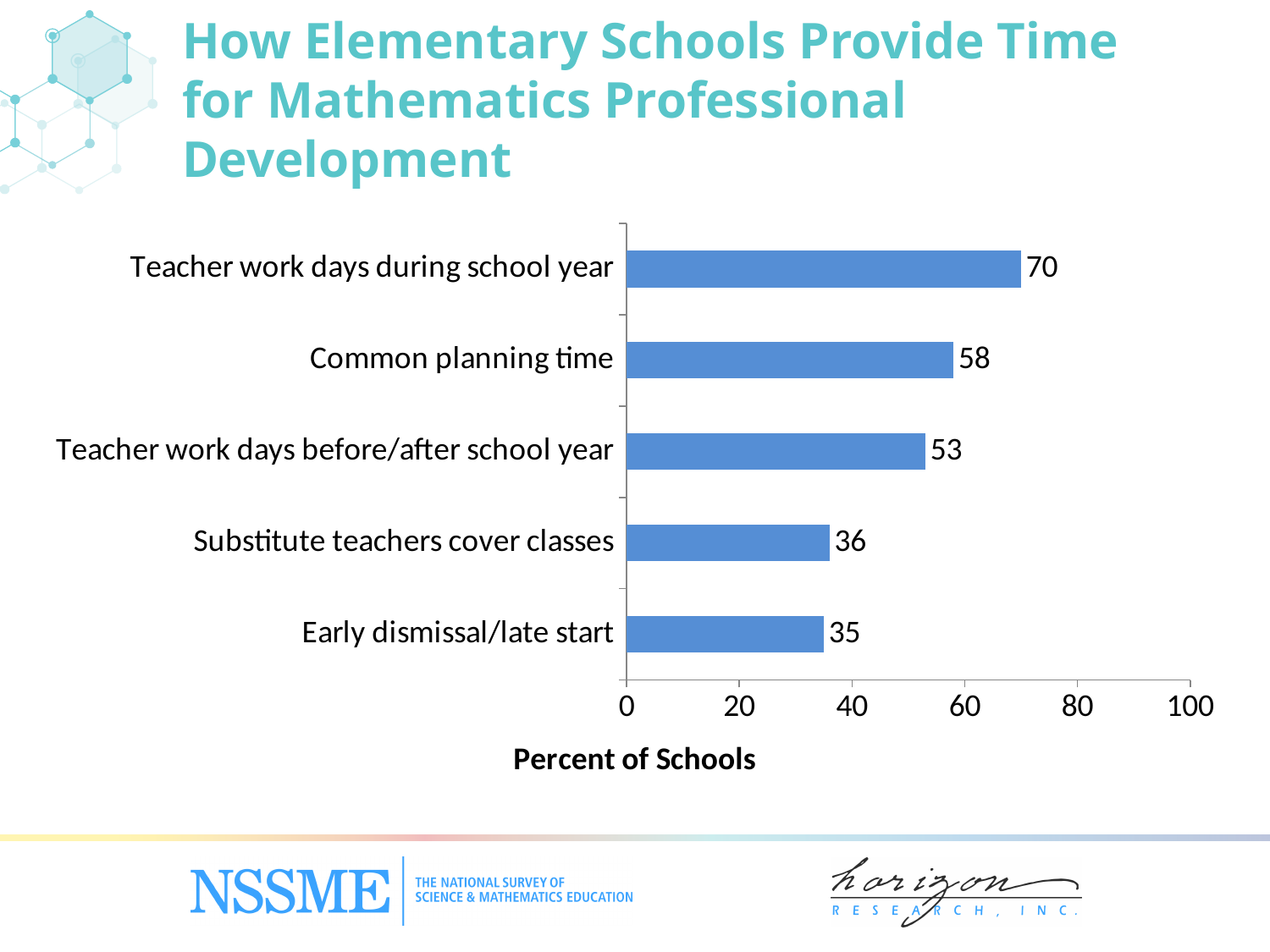
What is the value for Early dismissal/late start? 35 What is the value for Common planning time? 58 What percent of schools provide time for mathematics professional development through teacher work days during the school year? 70 Which category has the highest percent of schools? Teacher work days during school year What kind of chart is shown on the slide? Bar chart How many categories are shown in the chart? 5 Which is larger: the value for Common planning time or the value for Teacher work days before/after school year? Common planning time What is the difference between the values for Teacher work days during school year and Common planning time? 12 What is the label of the horizontal axis? Percent of Schools What is the value for Teacher work days before/after school year? 53 What is the value for Substitute teachers cover classes? 36 Which category has the lowest percent of schools? Early dismissal/late start